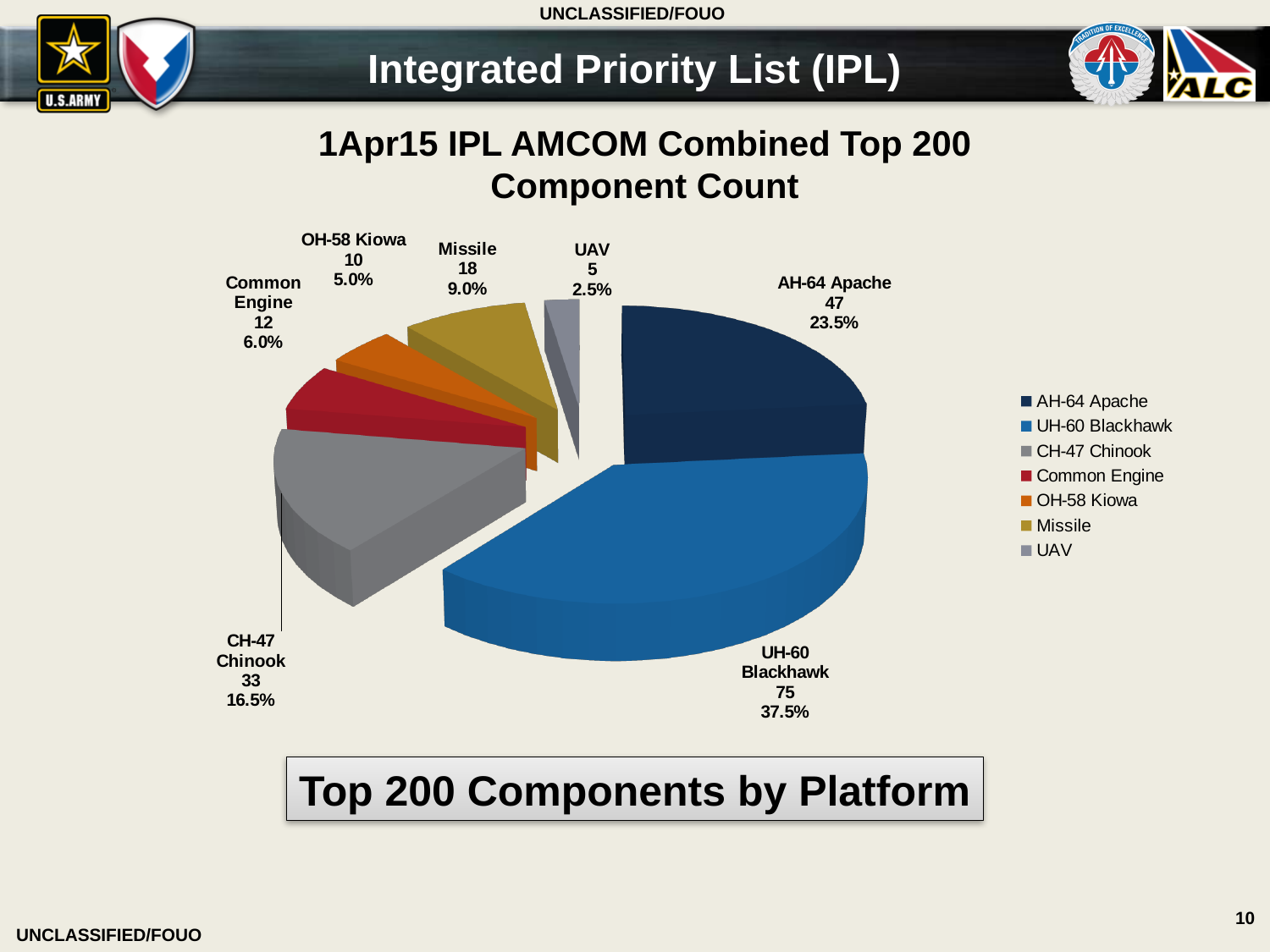
What percentage share does OH-58 Kiowa have? 5.0% What kind of chart is shown on the slide? pie chart What is the title of the chart? 1Apr15 IPL AMCOM Combined Top 200 Component Count What is the component count for UAV? 5 What is the component count for UH-60 Blackhawk? 75 How many platforms are listed in the legend? 7 Which platform has the smallest slice of the pie? UAV Which platform has the largest slice of the pie? UH-60 Blackhawk What is the difference in component count between UH-60 Blackhawk and AH-64 Apache? 28 What percentage share does AH-64 Apache have? 23.5% Which has a higher component count, Missile or Common Engine? Missile What is the component count for CH-47 Chinook? 33